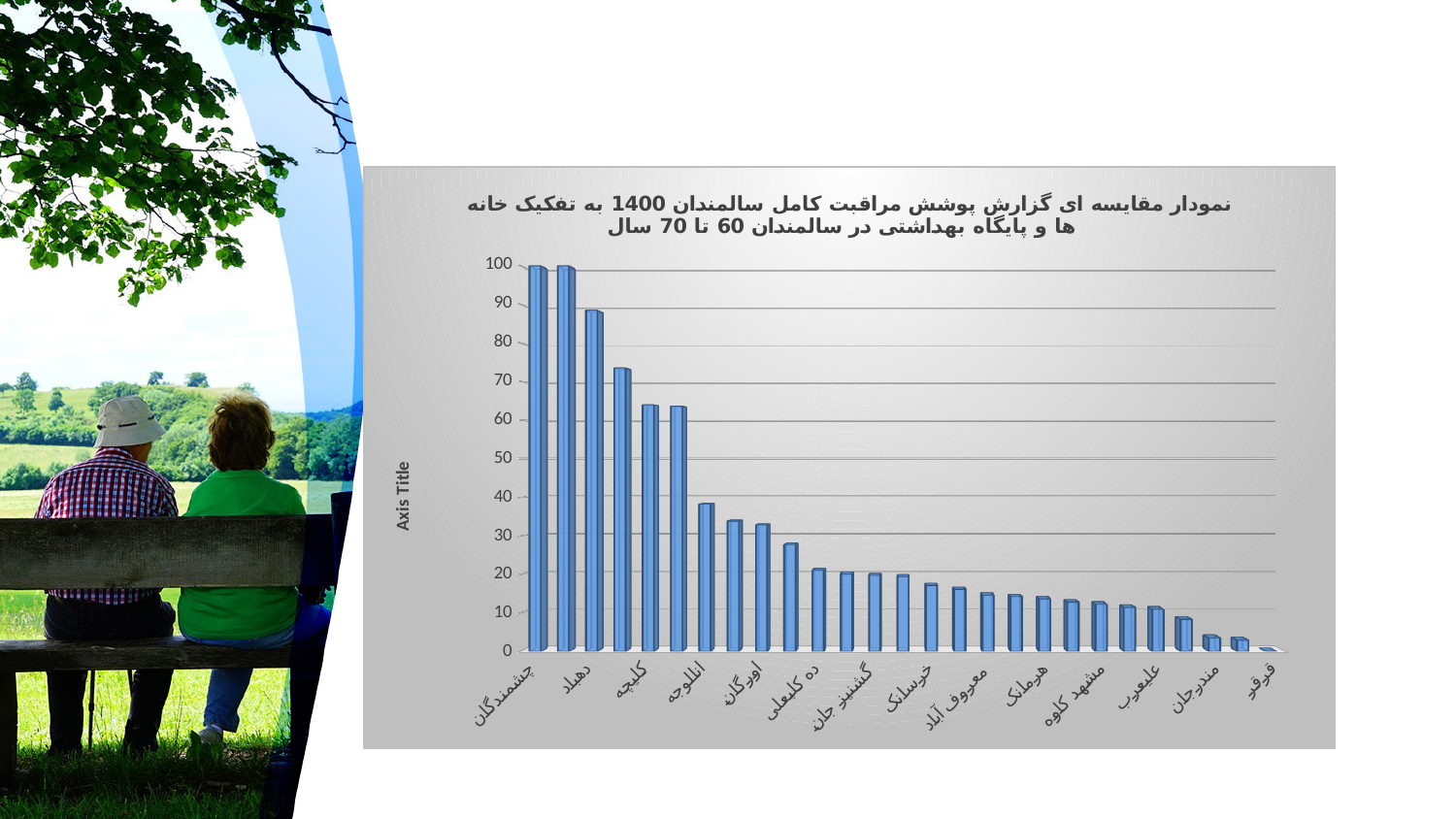
What kind of chart is shown on the slide? bar chart Do the values generally rise or fall moving from left to right along the x axis? fall Which category has the lowest value in the chart? قرقر What is the label shown on the vertical axis of the chart? Axis Title Which is larger, the value for چشمندگان or the value for قرقد? چشمندگان Is the value for انلوجه greater or less than 30? greater Is the value for کلیجه greater or less than 60? greater Is the value for مندرجان greater or less than 10? less Which is larger, the value for دهباد or the value for کلیجه? دهباد